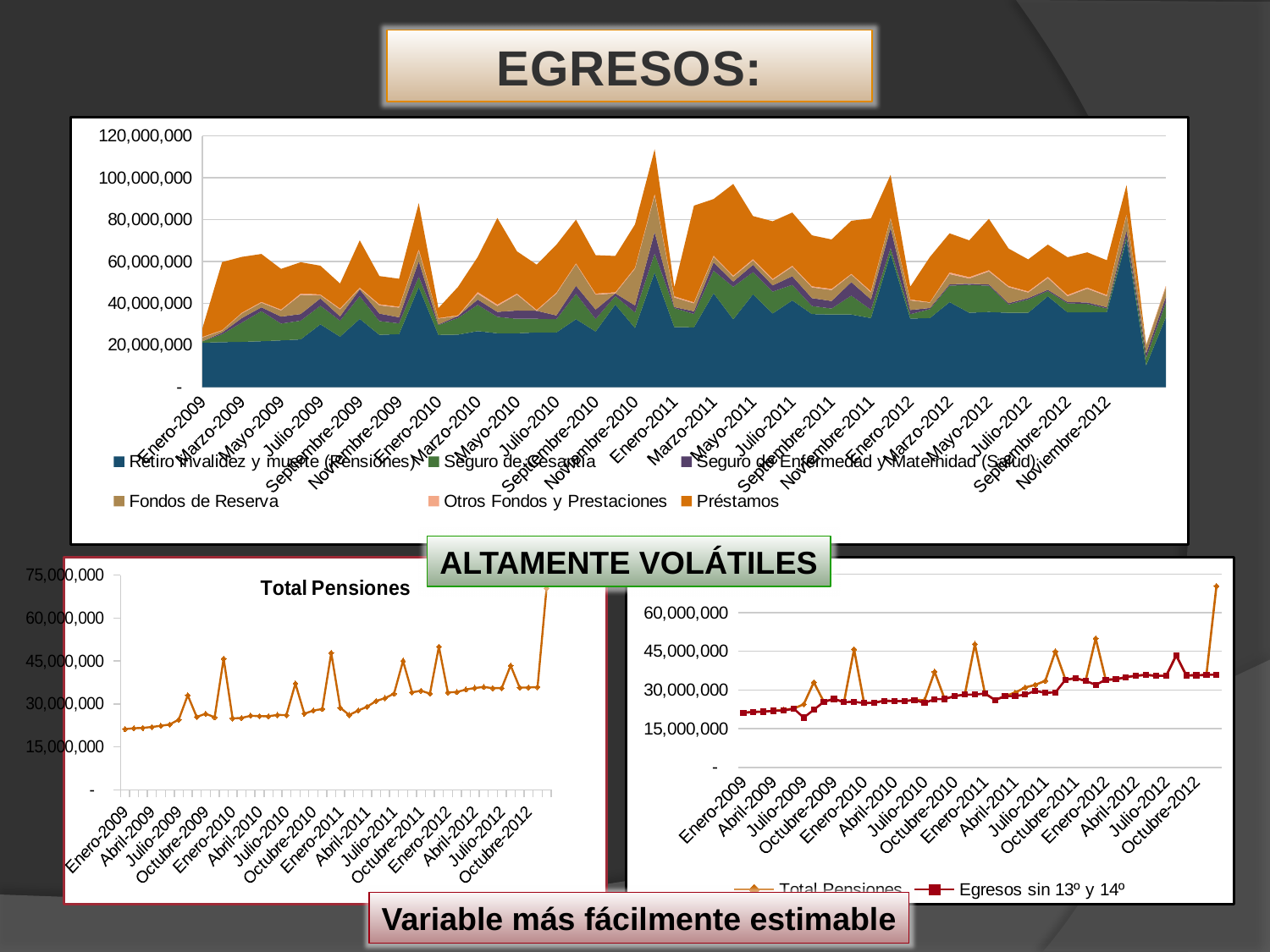
In the bottom-left 'Total Pensiones' chart, do the values generally rise or fall from 2009 to 2012? Rise How many series does the legend of the top chart list? 6 How many series does the legend of the bottom-right chart list? 2 What kind of chart is the top chart on the slide? Area chart What kind of chart is the bottom-left 'Total Pensiones' chart? Line chart In the bottom-left 'Total Pensiones' chart, is the value for Enero-2009 greater or less than 15,000,000? greater In the bottom-right chart, which series has the higher value at the final point at the end of 2012, Total Pensiones or Egresos sin 13º y 14º? Total Pensiones In the top chart, is the peak value around Enero-2011 greater or less than 100,000,000? greater In the bottom-right chart, is the value of Egresos sin 13º y 14º for Enero-2009 greater or less than 30,000,000? less In the top chart, which series is shown in orange? Préstamos